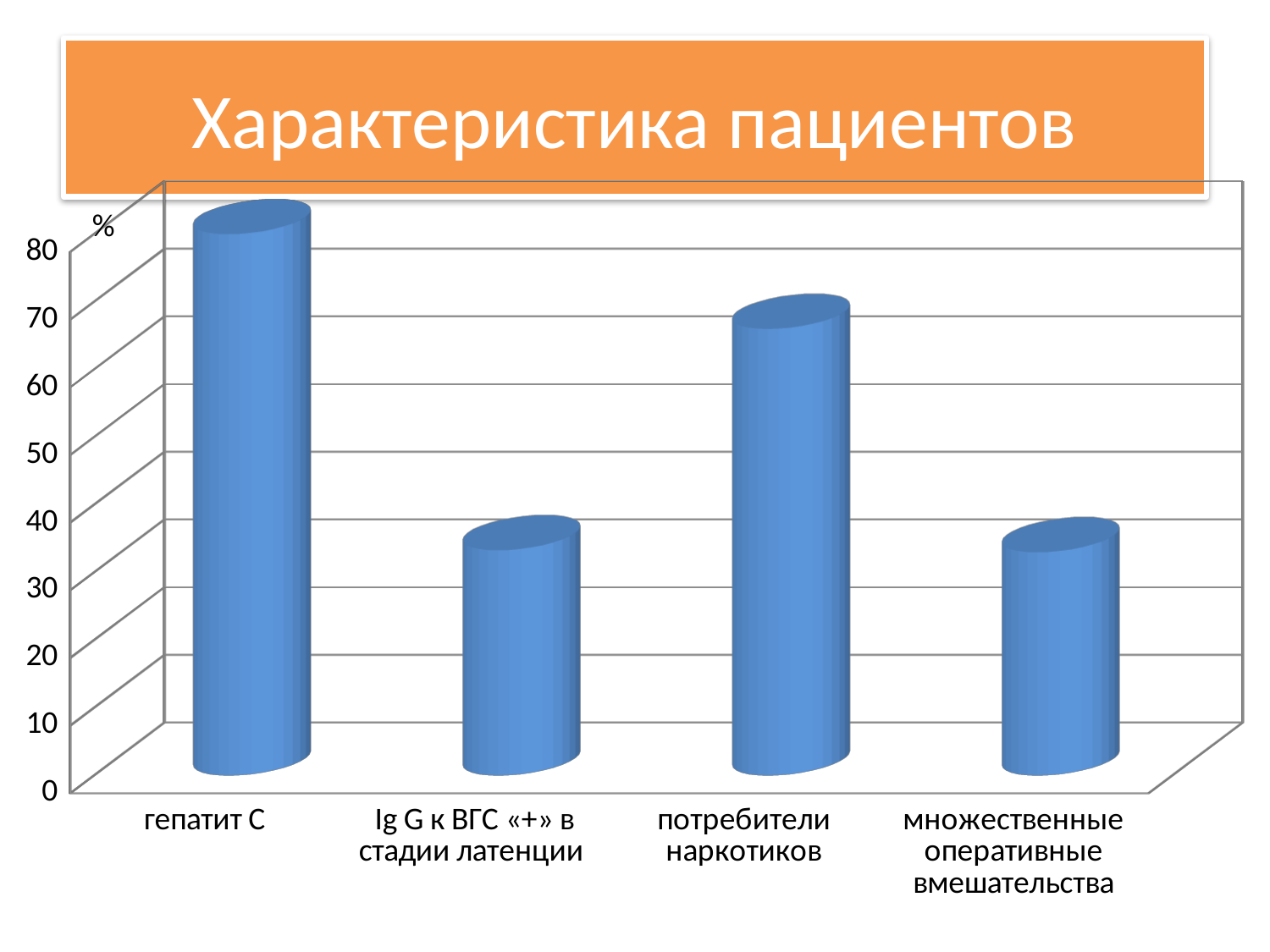
Which category has the highest value? гепатит С Which is larger: the value for потребители наркотиков or the value for Ig G к ВГС «+» в стадии латенции? потребители наркотиков What unit is shown on the vertical axis of the chart? % Is the value for потребители наркотиков greater or less than 60? greater Which is larger: the value for гепатит С or the value for потребители наркотиков? гепатит С Is the value for гепатит С greater or less than 70? greater What is the title of the slide? Характеристика пациентов Is the value for множественные оперативные вмешательства greater or less than 20? greater How many categories are plotted in the chart? 4 What kind of chart is shown on the slide? bar chart